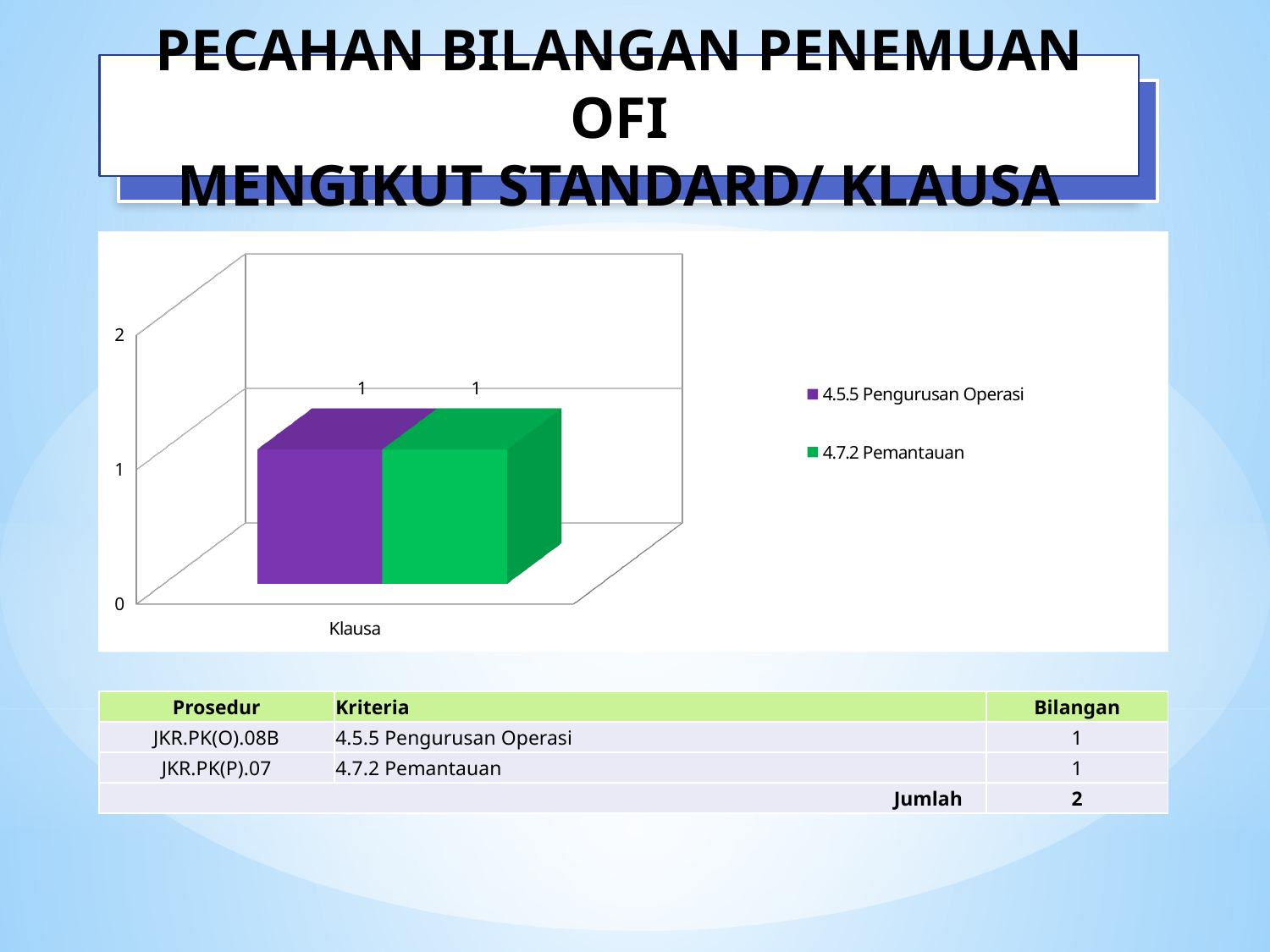
What is the label on the x axis of the chart? Klausa What is the value for 4.5.5 Pengurusan Operasi in the chart? 1 What is the highest value shown on the chart's vertical axis? 2 What is the value for 4.7.2 Pemantauan in the chart? 1 How many series does the chart legend list? 2 How many bars are plotted in the chart? 2 Which colour represents 4.7.2 Pemantauan in the chart? green Is the value for 4.7.2 Pemantauan greater or less than 2? less What kind of chart is shown on the slide? bar chart What is the difference between the values for 4.5.5 Pengurusan Operasi and 4.7.2 Pemantauan? 0